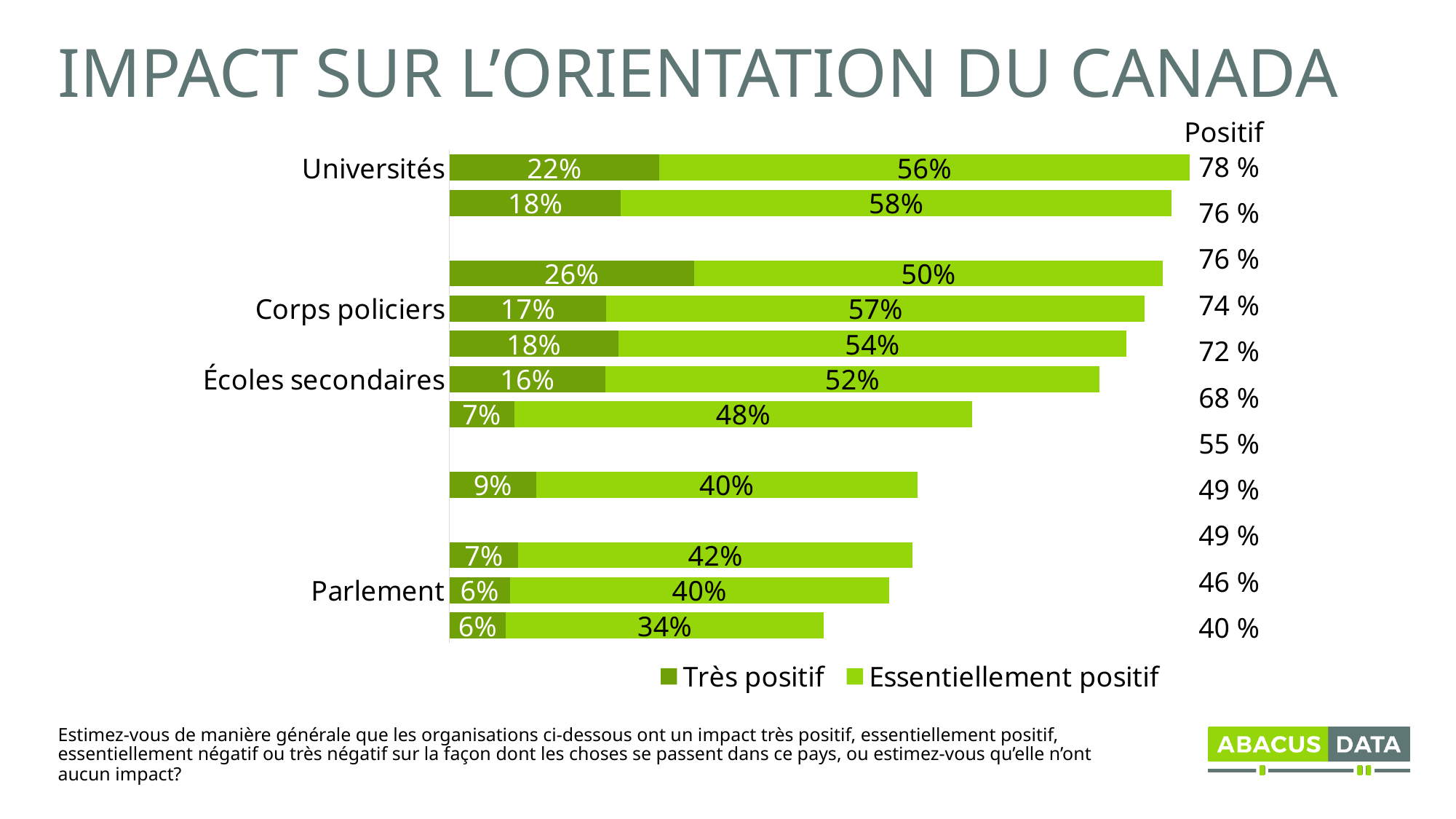
What is the 'Très positif' value for Corps policiers? 17% What kind of chart is shown on the slide? Stacked bar chart What is the 'Essentiellement positif' value for Universités? 56% What is the combined total of the two segments of the Universités bar? 78% Which has the larger 'Très positif' value, Corps policiers or Écoles secondaires? Corps policiers What is the lowest 'Essentiellement positif' value shown on any bar in the chart? 34% What is the highest 'Très positif' value shown on any bar in the chart? 26% How many series does the legend list? 2 What is the 'Essentiellement positif' value for Parlement? 40% What is the 'Très positif' value for Universités? 22% What is the 'Essentiellement positif' value for Écoles secondaires? 52% What is the difference between the 'Très positif' values for Universités and Parlement? 16 percentage points